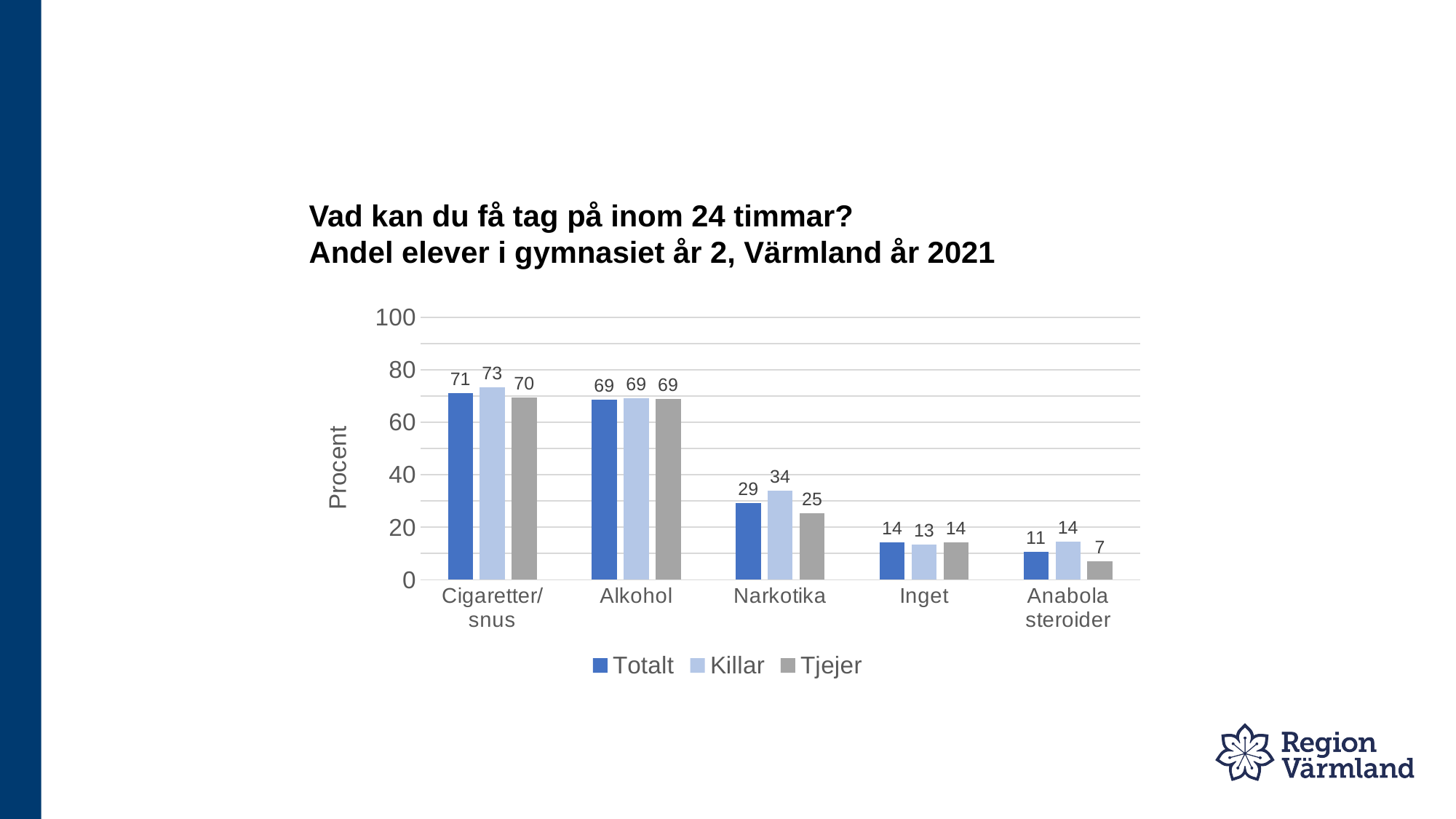
What kind of chart is shown on the slide? bar chart Is the Totalt value for Alkohol greater or less than 60? greater How many series does the legend list? 3 What is the difference between the Killar and Tjejer values for Narkotika? 9 What is the Killar value for Cigaretter/snus? 73 What is the Totalt value for Narkotika? 29 Which category has the highest Totalt value? Cigaretter/snus What is the label of the y axis? Procent What is the Tjejer value for Anabola steroider? 7 How many categories are shown on the x axis? 5 Which is larger for Anabola steroider, the Killar value or the Tjejer value? Killar Which category has the lowest Tjejer value? Anabola steroider